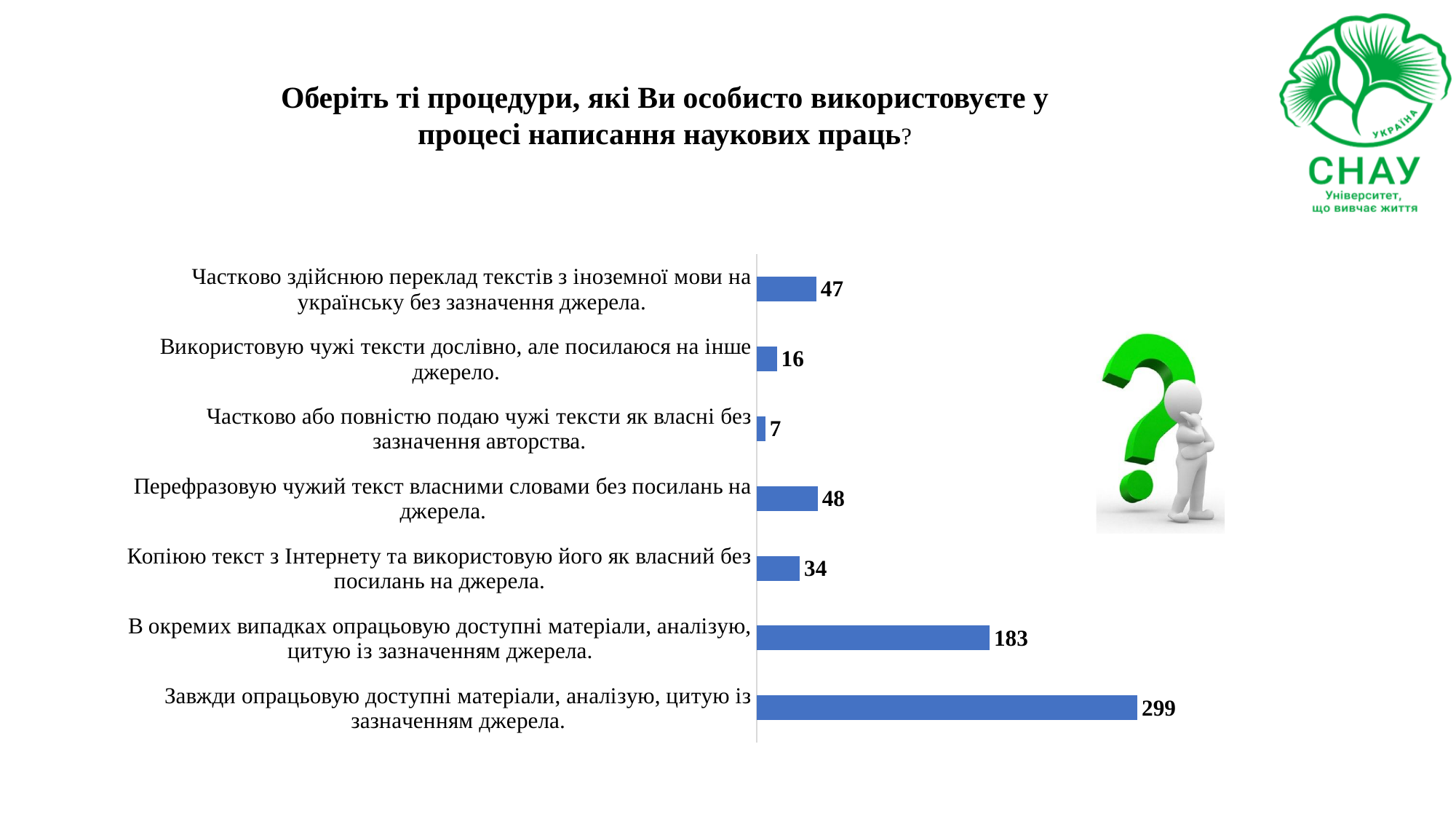
What is the title of the chart? Оберіть ті процедури, які Ви особисто використовуєте у процесі написання наукових праць? What kind of chart is shown on the slide? Bar chart What is the value for "Використовую чужі тексти дослівно, але посилаюся на інше джерело"? 16 What is the value for "Копіюю текст з Інтернету та використовую його як власний без посилань на джерела"? 34 How many categories are shown in the chart? 7 Which is larger: the value for "В окремих випадках опрацьовую доступні матеріали..." or the value for "Частково здійснюю переклад текстів з іноземної мови..."? В окремих випадках опрацьовую доступні матеріали, аналізую, цитую із зазначенням джерела. Which category has the highest value? Завжди опрацьовую доступні матеріали, аналізую, цитую із зазначенням джерела. What is the difference between the values for "Перефразовую чужий текст власними словами без посилань на джерела" and "Копіюю текст з Інтернету та використовую його як власний без посилань на джерела"? 14 What is the difference between the values for "Завжди опрацьовую доступні матеріали..." and "В окремих випадках опрацьовую доступні матеріали..."? 116 Which category has the lowest value? Частково або повністю подаю чужі тексти як власні без зазначення авторства. What is the value for "Завжди опрацьовую доступні матеріали, аналізую, цитую із зазначенням джерела"? 299 What is the value for "Перефразовую чужий текст власними словами без посилань на джерела"? 48